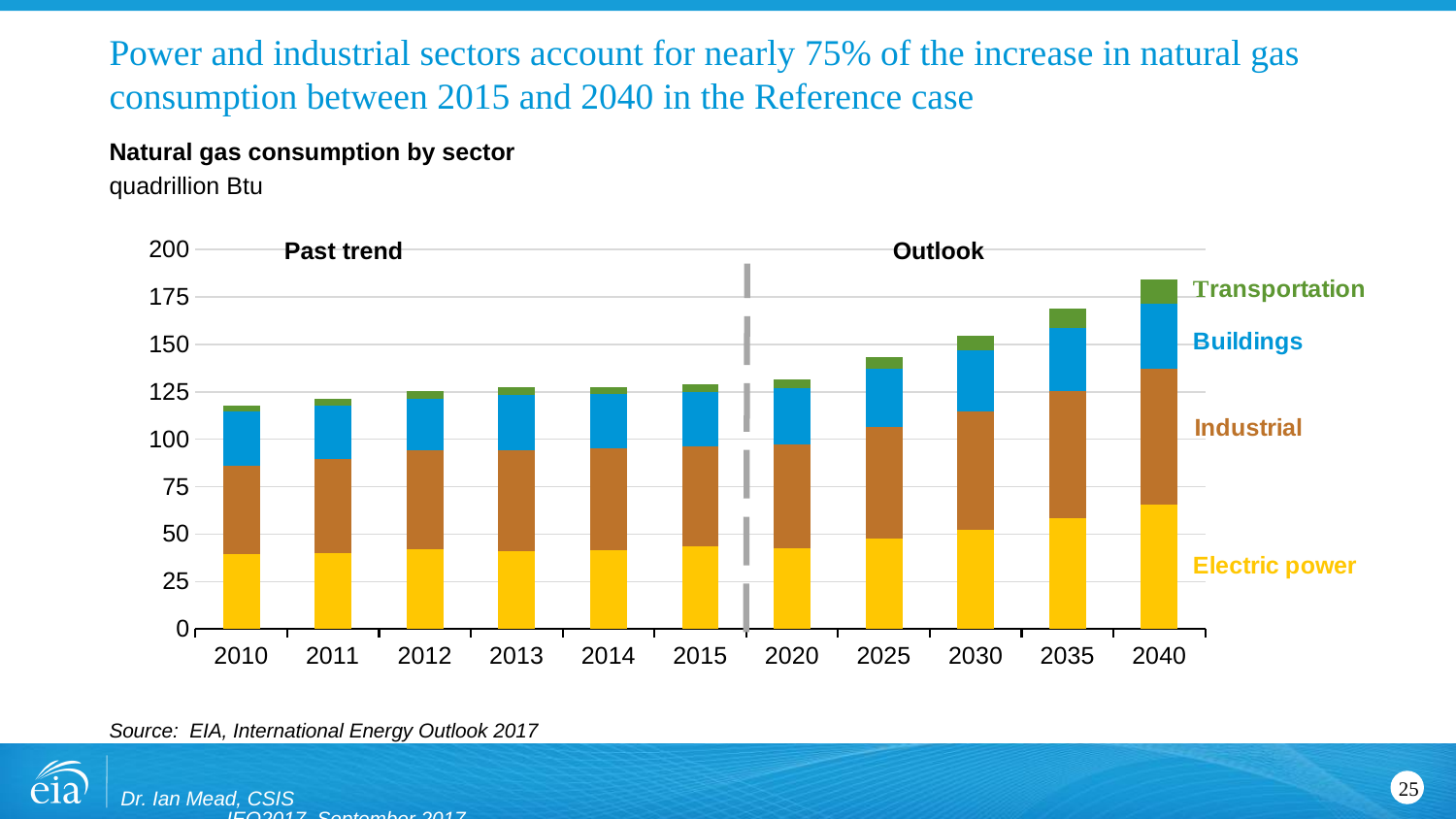
Is the Electric power consumption in 2040 greater or less than 50 quadrillion Btu? greater Does total natural gas consumption rise or fall from 2010 to 2040? rise What kind of chart is shown on the slide? stacked bar chart What unit is the chart measured in? quadrillion Btu Which year has the lowest total natural gas consumption? 2010 Is the total natural gas consumption in 2040 greater or less than 175 quadrillion Btu? greater Which year has the larger total natural gas consumption, 2015 or 2030? 2030 How many sectors (series) are stacked in each bar? 4 Is the total natural gas consumption in 2010 greater or less than 125 quadrillion Btu? less How many years are shown on the x axis of the chart? 11 Which year has the highest total natural gas consumption? 2040